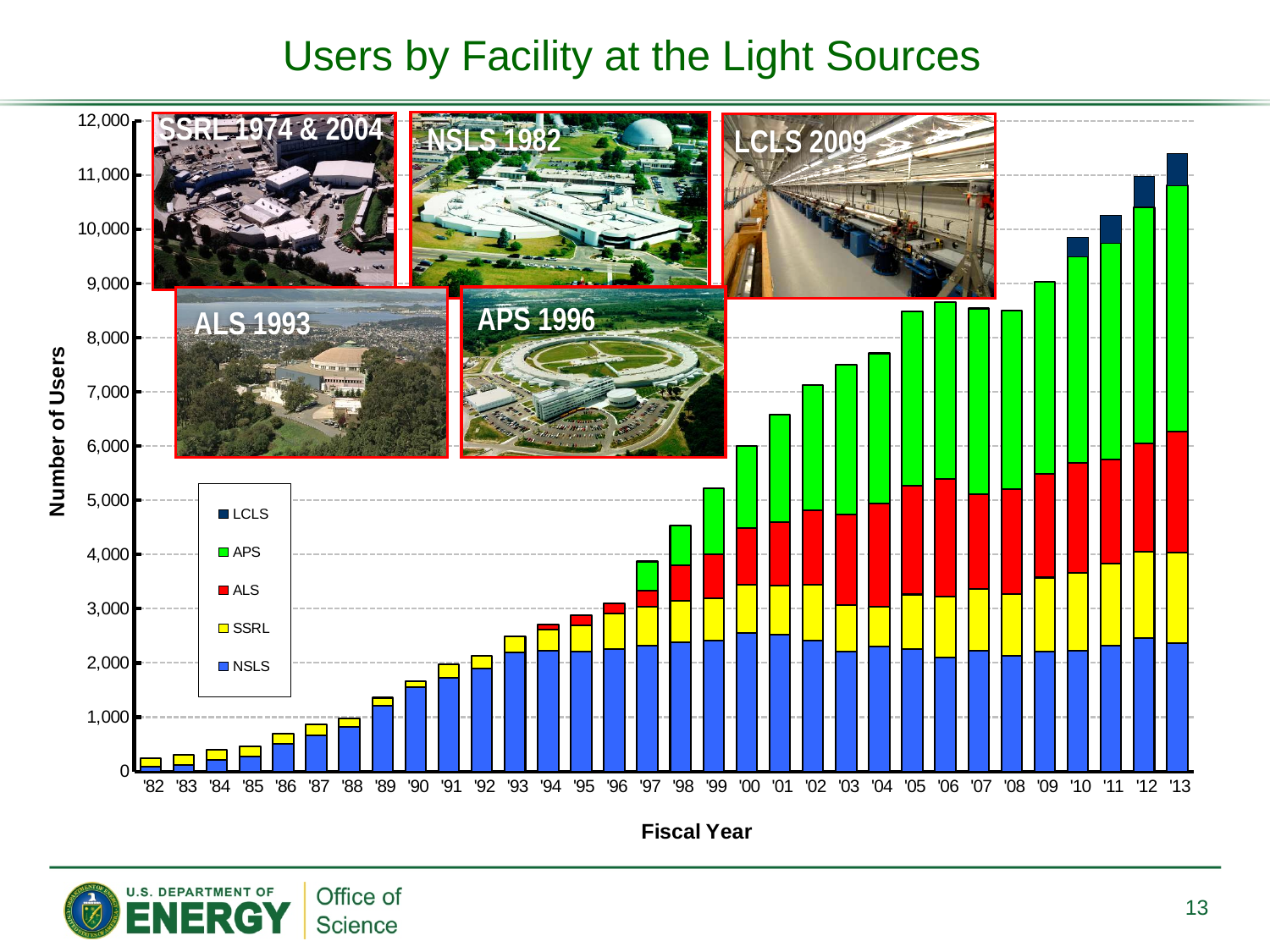
Is the total number of users in '01 greater or less than 6,000? greater Is the total number of users in '90 greater or less than 2,000? less What kind of chart is shown on the slide? Stacked bar chart Which fiscal year has a larger total number of users, '06 or '03? '06 Is the total number of users in '13 greater or less than 11,000? greater Do the total number of users generally rise or fall from '82 to '13? rise How many fiscal years are shown along the x axis? 32 Which fiscal year has the highest total number of users? '13 What is the label of the y axis? Number of Users What is the title of the chart? Users by Facility at the Light Sources How many series does the legend list? 5 Which fiscal year has the lowest total number of users? '82